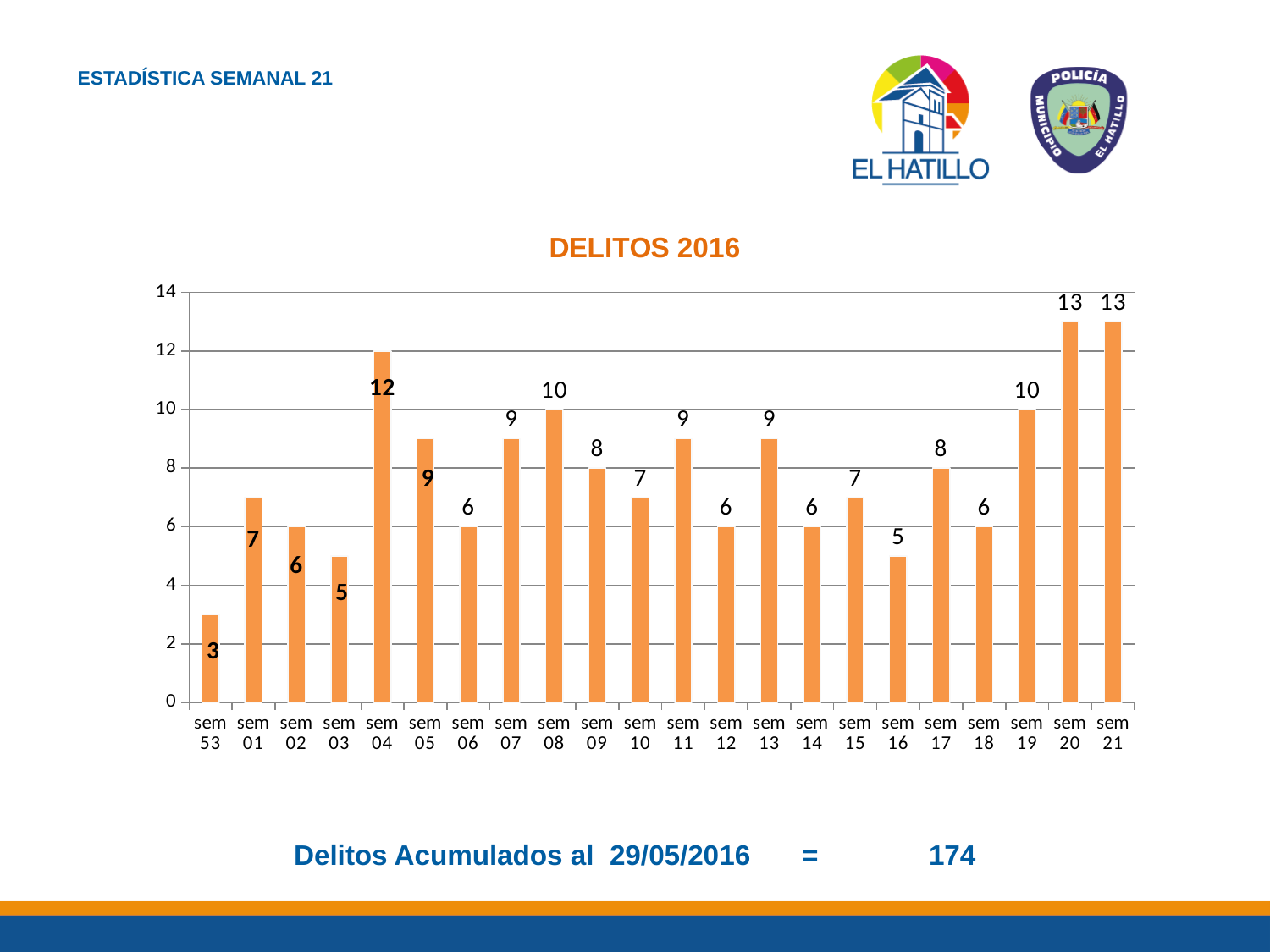
Do the values rise or fall from sem 18 to sem 21 in the DELITOS 2016 chart? rise What is the value for sem 16 in the DELITOS 2016 chart? 5 What is the value for sem 19 in the DELITOS 2016 chart? 10 What is the value for sem 53 in the DELITOS 2016 chart? 3 Is the value for sem 20 in the DELITOS 2016 chart greater or less than 12? greater What kind of chart is DELITOS 2016? bar chart How many weeks (bars) are shown in the DELITOS 2016 chart? 22 What is the highest value shown in the DELITOS 2016 chart? 13 What is the value for sem 04 in the DELITOS 2016 chart? 12 What is the difference between the values for sem 04 and sem 53 in the DELITOS 2016 chart? 9 Which week has the lowest value in the DELITOS 2016 chart? sem 53 Which is larger in the DELITOS 2016 chart, the value for sem 04 or the value for sem 08? sem 04